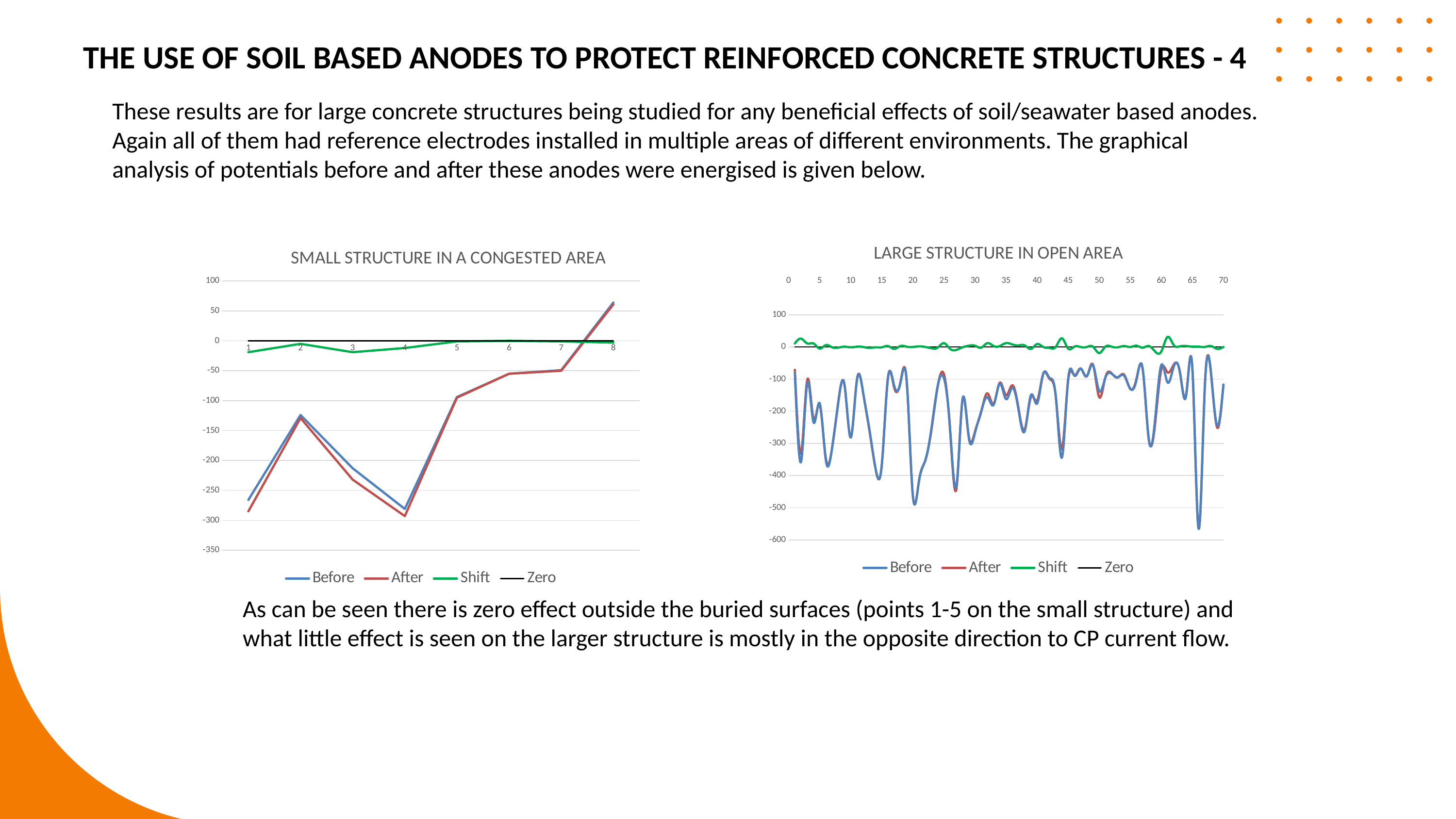
How many points are plotted along the x axis of the 'SMALL STRUCTURE IN A CONGESTED AREA' chart? 8 In the 'SMALL STRUCTURE IN A CONGESTED AREA' chart, at which point is the Before series highest? 8 How many series does the legend of the 'SMALL STRUCTURE IN A CONGESTED AREA' chart list? 4 In the 'SMALL STRUCTURE IN A CONGESTED AREA' chart, is the After value at point 8 greater or less than 50? greater In the 'SMALL STRUCTURE IN A CONGESTED AREA' chart, does the Before series rise or fall from point 4 to point 8? rise What kind of chart is the 'LARGE STRUCTURE IN OPEN AREA' chart? line chart In the 'SMALL STRUCTURE IN A CONGESTED AREA' chart, at point 3 which is larger, the Before value or the After value? Before What kind of chart is the 'SMALL STRUCTURE IN A CONGESTED AREA' chart? line chart In the 'SMALL STRUCTURE IN A CONGESTED AREA' chart, at which point is the Before series lowest? 4 In the 'LARGE STRUCTURE IN OPEN AREA' chart, is the lowest Before value greater or less than -500? less In the 'SMALL STRUCTURE IN A CONGESTED AREA' chart, is the Before value at point 1 greater or less than -250? less What is the title of the chart on the right of the slide? LARGE STRUCTURE IN OPEN AREA